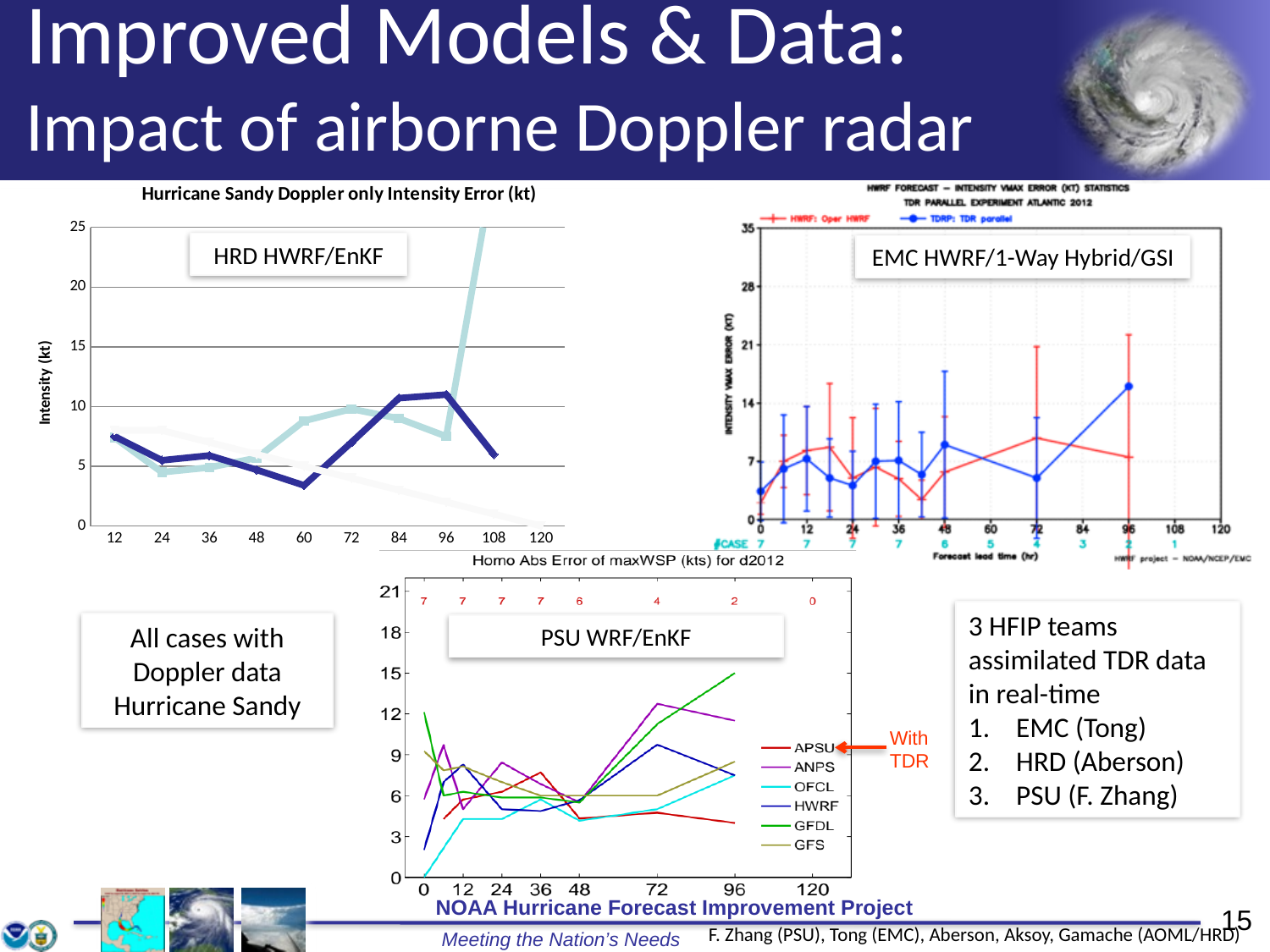
In the top-right 'HWRF FORECAST – INTENSITY VMAX ERROR (KT) STATISTICS' chart, is the blue TDR parallel value at 96 hours greater or less than 14? greater In the bottom 'Homo Abs Error of maxWSP (kts) for d2012' chart, is the GFDL value at 96 hours greater or less than 12? greater In the bottom 'Homo Abs Error of maxWSP (kts) for d2012' chart, what is the OFCL value at 0 hours? 0 How many series does the legend list in the bottom 'Homo Abs Error of maxWSP (kts) for d2012' chart? 6 In the 'Hurricane Sandy Doppler only Intensity Error (kt)' chart, is the dark blue line's value at 96 hours greater or less than 10? greater What type of chart is the 'Hurricane Sandy Doppler only Intensity Error (kt)' chart? line chart In the top-right 'HWRF FORECAST – INTENSITY VMAX ERROR (KT) STATISTICS' chart, how many cases are listed for the 96-hour lead time? 2 In the 'Hurricane Sandy Doppler only Intensity Error (kt)' chart, what is the label of the y axis? Intensity (kt) How many series does the legend list in the top-right 'HWRF FORECAST – INTENSITY VMAX ERROR (KT) STATISTICS' chart? 2 In the 'Hurricane Sandy Doppler only Intensity Error (kt)' chart, which model label is shown in the text box over the plot? HRD HWRF/EnKF